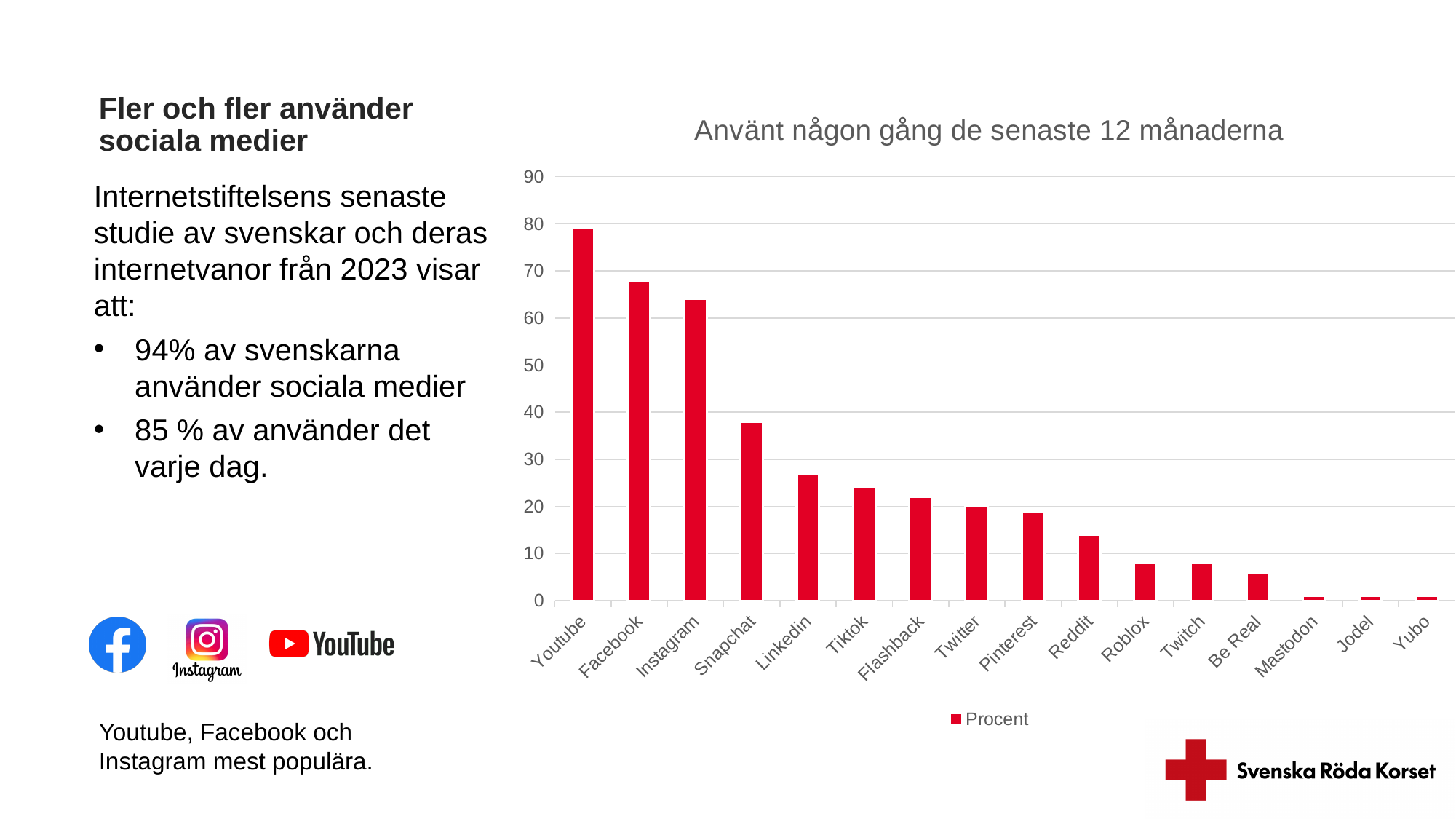
How many series does the chart legend list? 1 Which has a larger value, Facebook or Instagram? Facebook Do the values rise or fall moving from left to right along the x axis? fall Which category has the highest value in the chart? Youtube What kind of chart is shown on the slide? bar chart Is the value for Youtube greater or less than 70? greater What is the title of the chart? Använt någon gång de senaste 12 månaderna Which has a larger value, Snapchat or Tiktok? Snapchat How many categories are shown on the x axis of the chart? 16 Is the value for Snapchat greater or less than 40? less Is the value for Linkedin greater or less than 20? greater